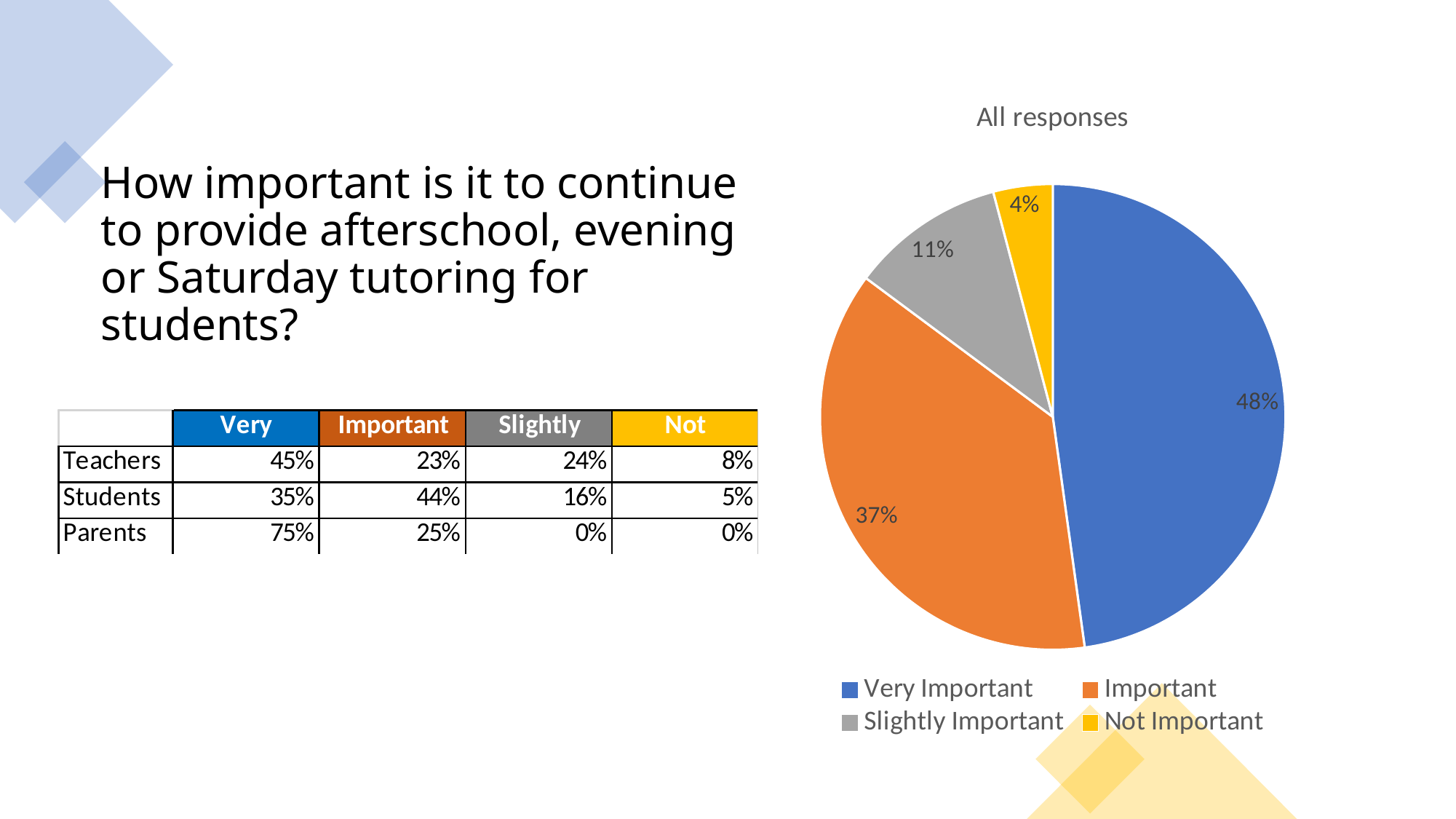
What share of all responses is Slightly Important? 11% What is the title of the chart? All responses Which category has the smallest slice of the pie? Not Important How many categories does the pie chart show? 4 What colour is the Important slice? orange Which is larger, the Slightly Important slice or the Not Important slice? Slightly Important What is the difference between the Very Important and Important shares? 11% What share of all responses is Not Important? 4% What share of all responses is Very Important? 48% What type of chart is shown on the slide? pie chart Which category has the largest slice of the pie? Very Important What share of all responses is Important? 37%